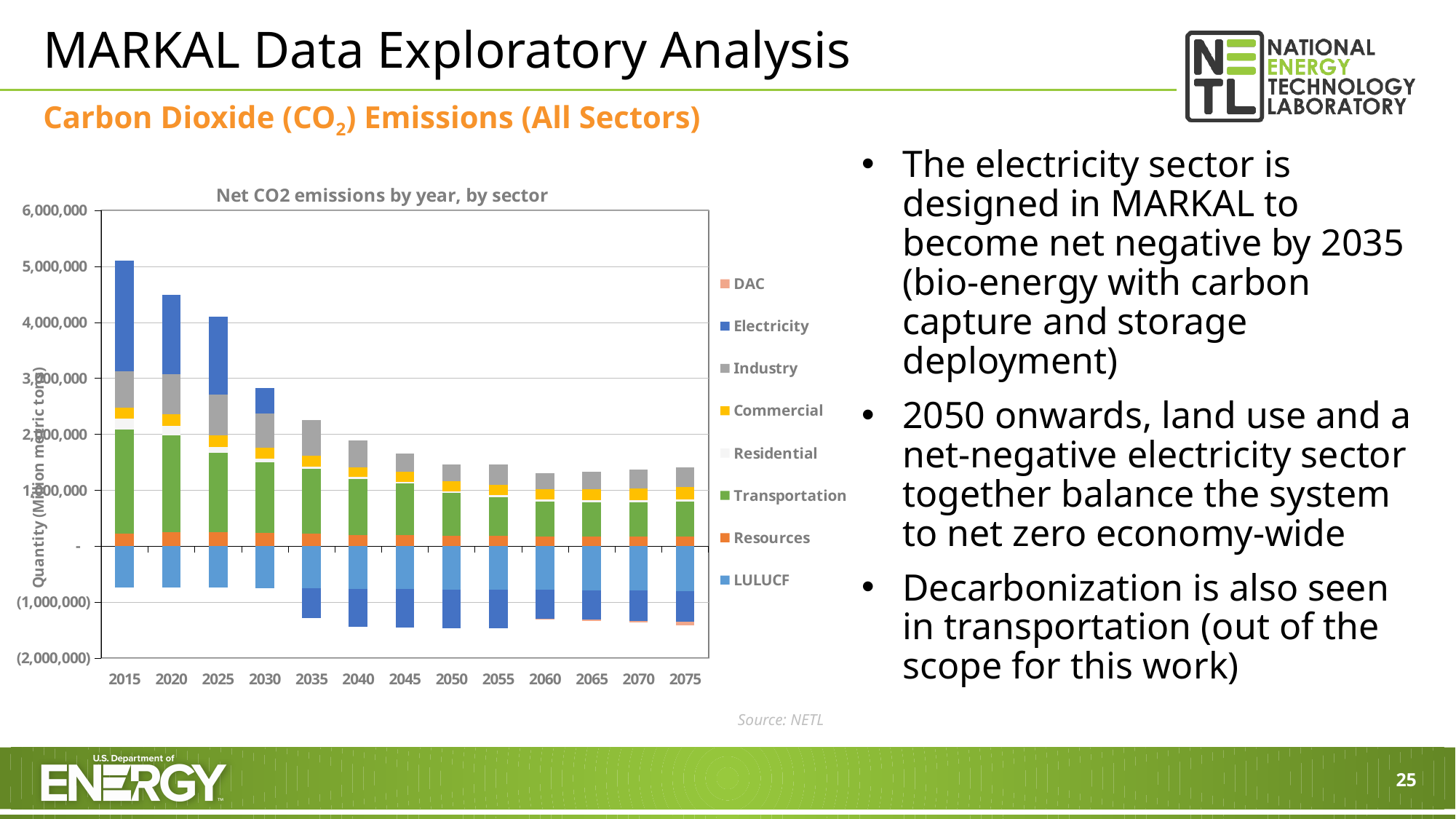
Is the total positive emissions stack for 2015 greater or less than 4,000,000? greater Which year has a larger total of positive emissions, 2015 or 2030? 2015 What is the title of the chart? Net CO2 emissions by year, by sector Is the value for Electricity in 2015 greater or less than 0? greater How many years are shown along the x axis of the chart? 13 Which year has the highest total of positive emissions in the chart? 2015 What is the label on the y axis of the chart? Quantity (Million metric tons) Do the total positive emissions rise or fall from 2015 to 2075? fall Is the total positive emissions stack for 2075 greater or less than 2,000,000? less What kind of chart is shown on the slide? Stacked bar chart How many series does the chart legend list? 8